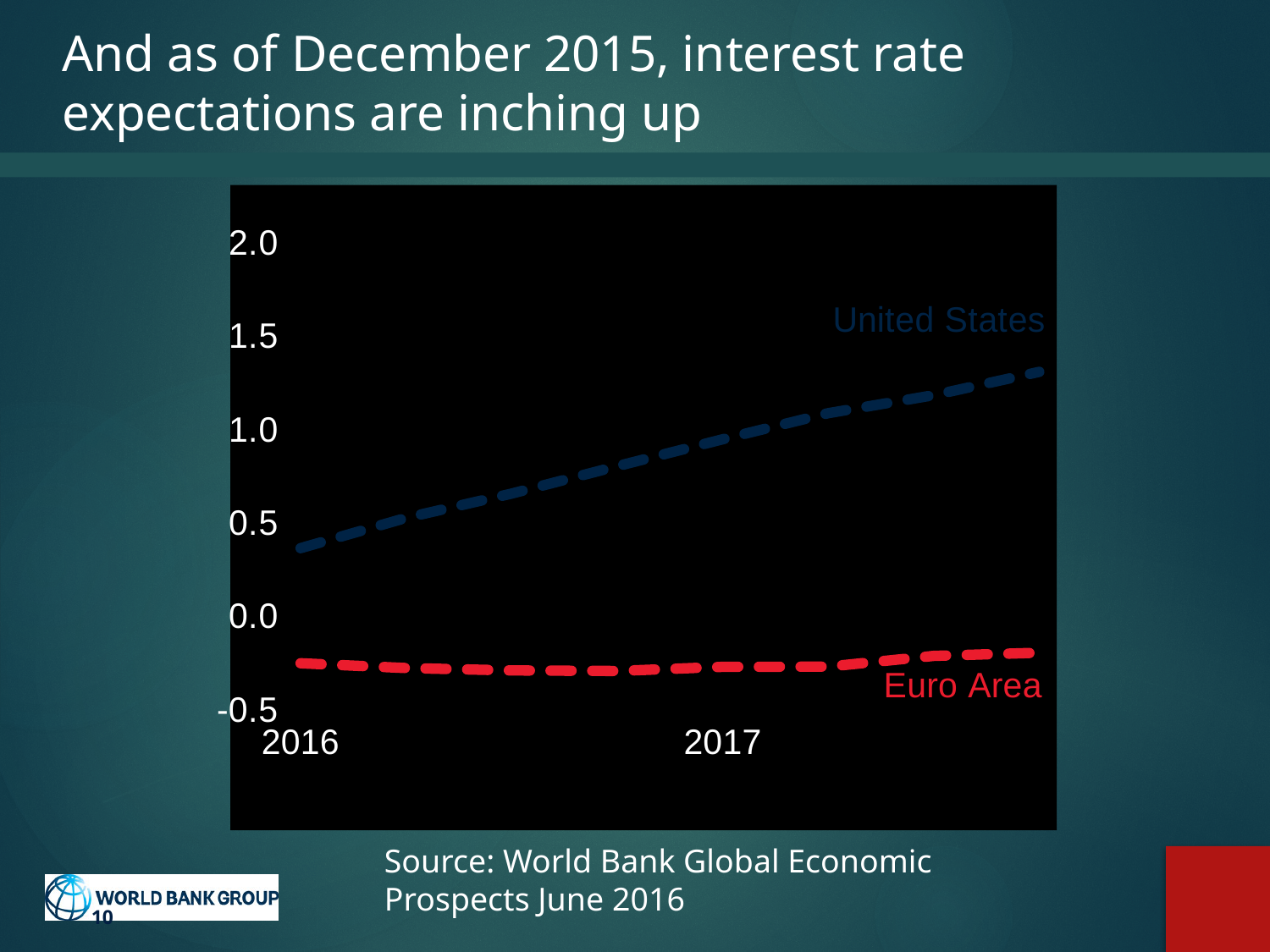
How many series are plotted on the chart? 2 Is the value for the United States at the start of 2016 greater or less than 0.5? less Is the value for the Euro Area at the start of 2016 greater or less than 0.0? less Does the United States line rise or fall from 2016 to 2017? rise Which series has higher values throughout the chart, United States or Euro Area? United States Is the value for the Euro Area at the right end of the chart greater or less than 0.0? less What kind of chart is shown on the slide? line chart What colour is the Euro Area line? red Which two series are labelled on the chart? United States and Euro Area How many year labels are shown on the x axis? 2